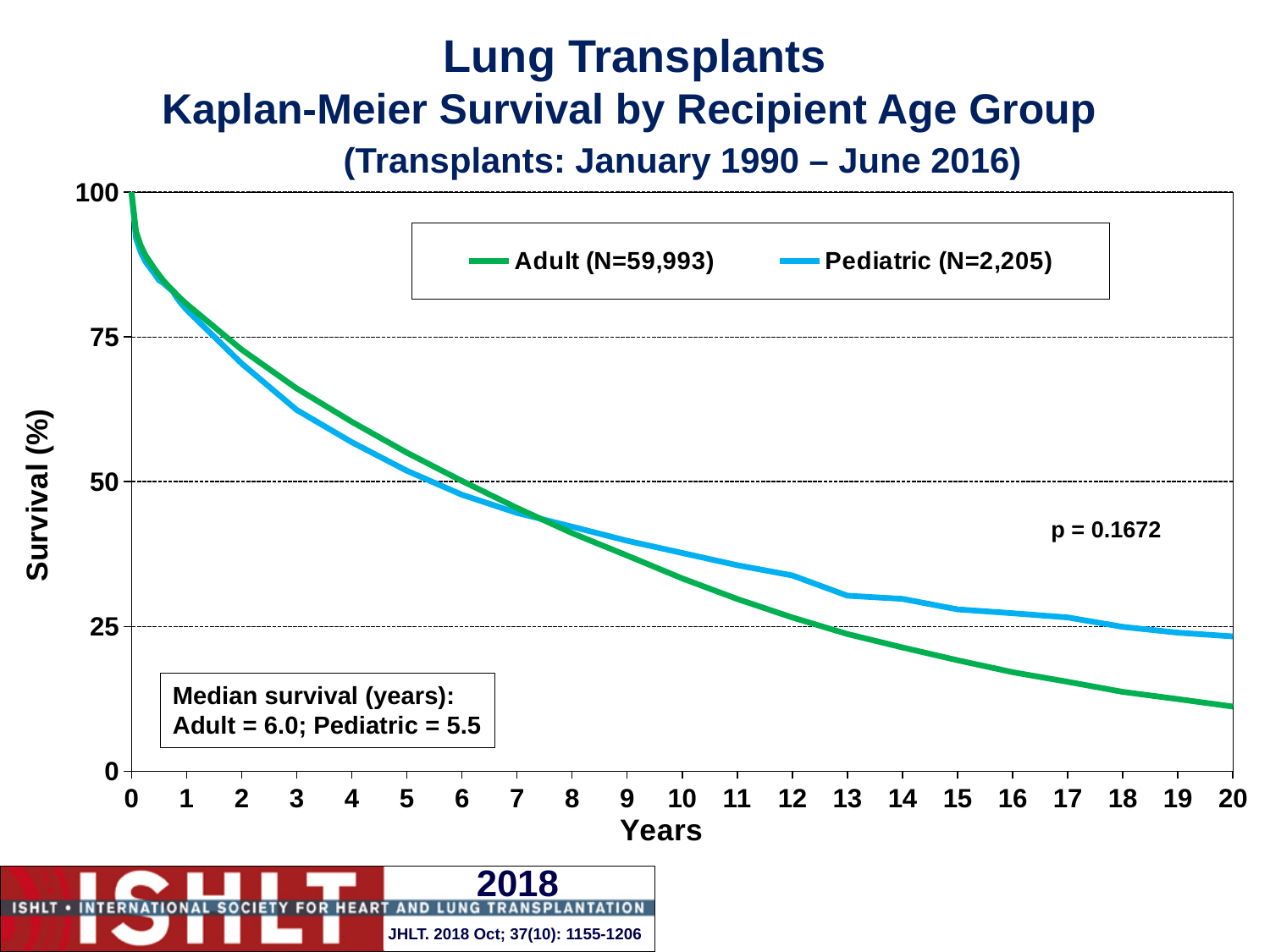
What is the difference in median survival (years) between the Adult and Pediatric groups? 0.5 What p-value is shown on the chart? p = 0.1672 What is the median survival in years for the Adult group? 6.0 Is the Adult survival at 20 years greater or less than 25? less How many series does the legend list? 2 What is the N for the Adult group shown in the legend? 59,993 What are the two series named in the legend? Adult (N=59,993) and Pediatric (N=2,205) What kind of chart is shown on the slide? Line chart What is the median survival in years for the Pediatric group? 5.5 Is the Pediatric survival at 10 years greater or less than 25? greater Do the survival curves rise or fall as years increase? Fall At 15 years, which group has the higher survival, Adult or Pediatric? Pediatric